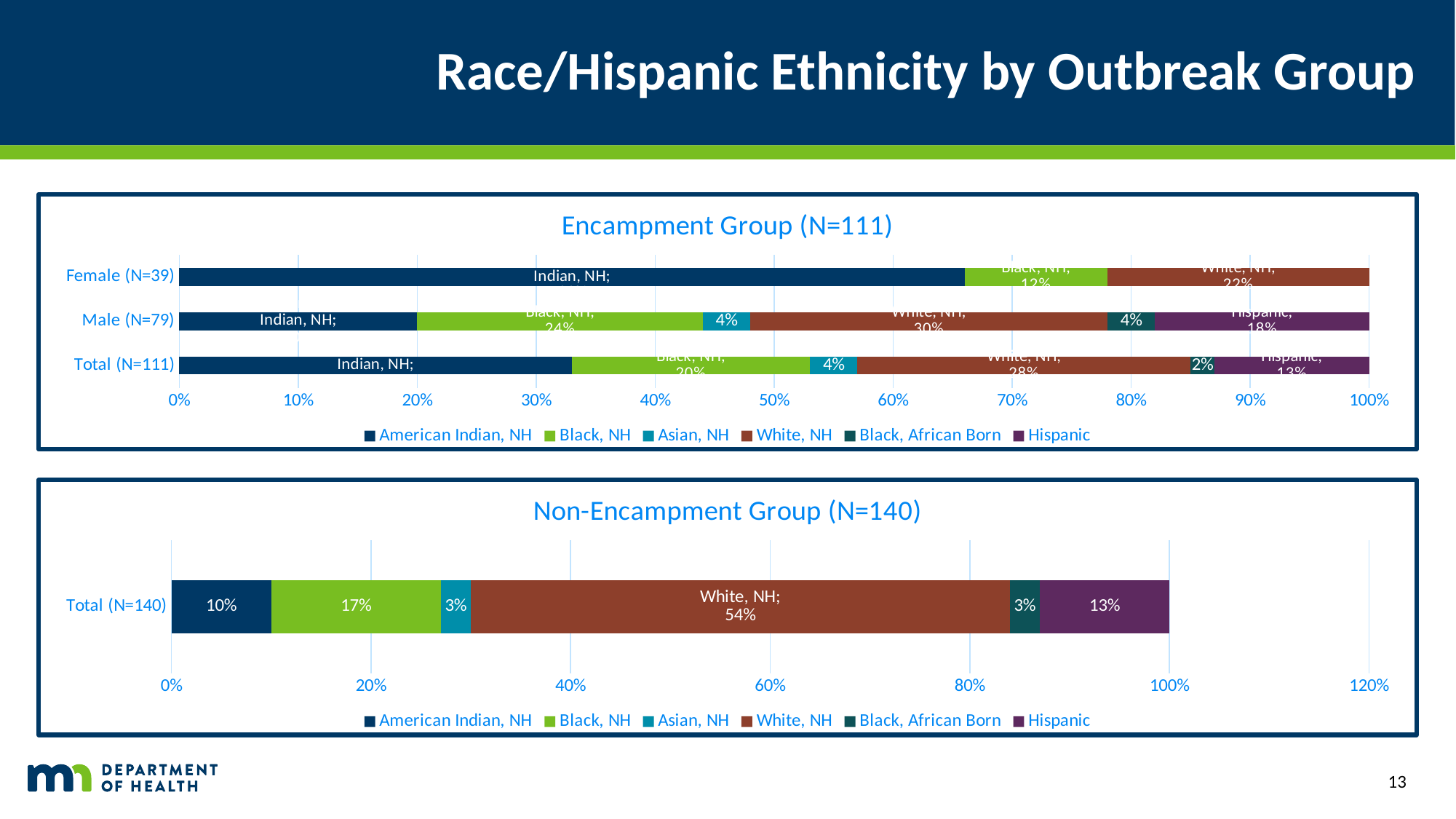
In the Non-Encampment Group chart, which series has the largest segment? White, NH In the Non-Encampment Group chart, what is the value for Hispanic? 13% In the Non-Encampment Group chart, what is the difference between the White, NH value and the Black, NH value? 37% In the Non-Encampment Group chart, which is larger, Black, NH or Hispanic? Black, NH What kind of chart is the Encampment Group chart? Stacked bar chart In the Non-Encampment Group chart, what is the value for American Indian, NH? 10% In the Encampment Group chart, what is the Asian, NH value for Male (N=79)? 4% In the Encampment Group chart, is the American Indian, NH value for Female (N=39) greater or less than 60%? greater In the Non-Encampment Group chart, what is the value for White, NH? 54% How many series does the legend of the Encampment Group chart list? 6 In the Encampment Group chart, what is the Black, African Born value for Total (N=111)? 2% In the Non-Encampment Group chart, what is the total of the stacked bar for Total (N=140)? 100%